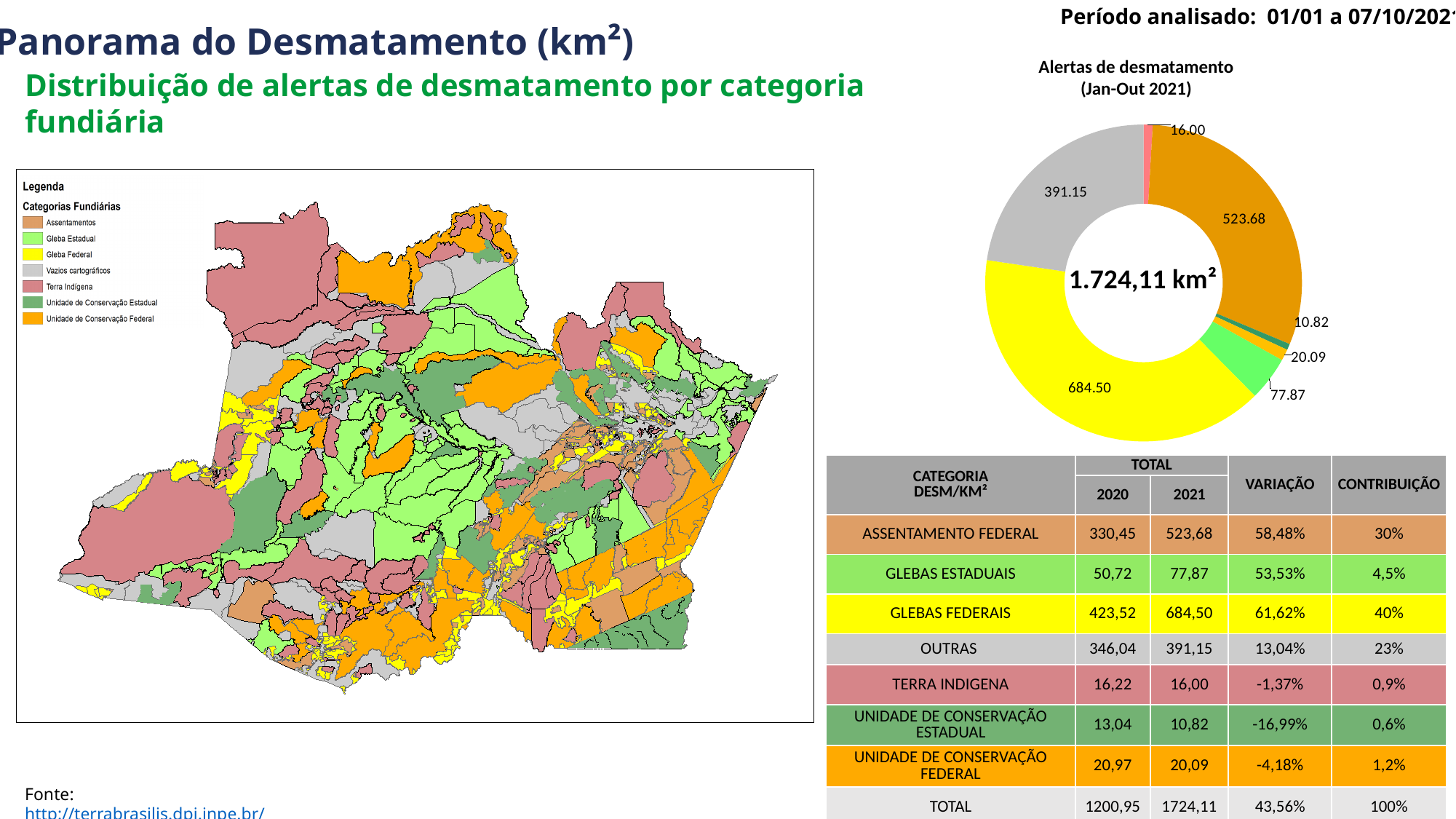
How many slices does the donut chart have? 7 In the donut chart, what value is labelled on the grey slice? 391.15 What is the title of the donut chart? Alertas de desmatamento (Jan-Out 2021) What is the value of the smallest slice in the donut chart? 10.82 What is the value of the largest slice in the donut chart? 684.50 In the donut chart, what value is labelled on the light green slice? 77.87 What total value is printed in the centre of the donut chart? 1.724,11 km² In the donut chart, which is larger: the grey slice (391.15) or the orange-brown slice (523.68)? 523.68 What kind of chart is shown under the title 'Alertas de desmatamento (Jan-Out 2021)'? Donut (pie) chart In the donut chart, what value is labelled on the pink slice? 16.00 In the donut chart, what is the difference between the yellow slice (684.50) and the orange-brown slice (523.68)? 160.82 In the donut chart, what is the difference between the slices labelled 20.09 and 16.00? 4.09